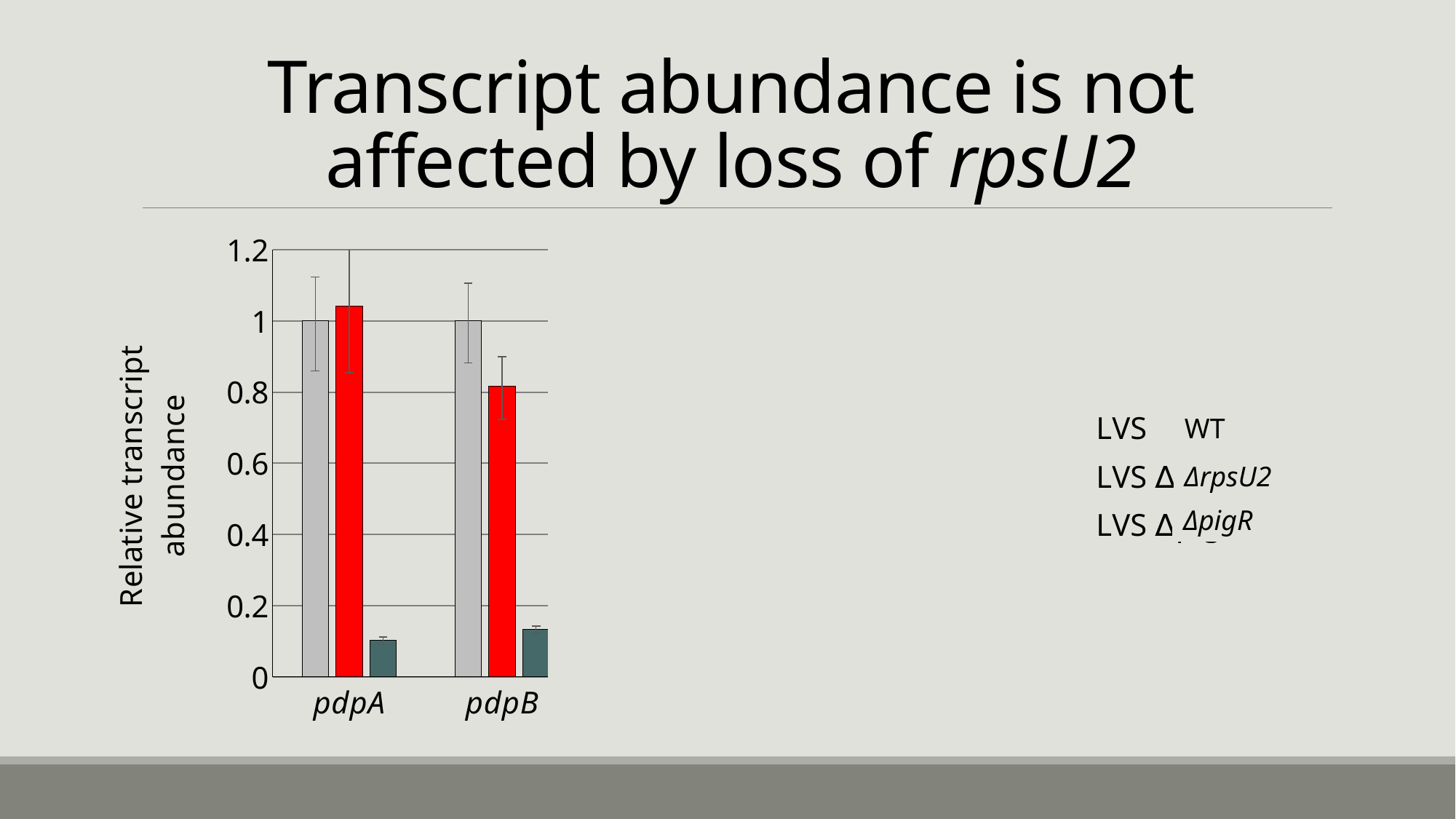
How many categories are shown on the x axis of the chart? 2 Is the value for the ΔpigR series at pdpA greater or less than 0.2? less What is the title of the chart's y axis? Relative transcript abundance Which series has the lowest value for pdpA? ΔpigR Which series has the highest value for pdpB? WT Is the value for the ΔpigR series at pdpB greater or less than 0.2? less How many series does the chart's legend list? 3 What is the relative transcript abundance of the WT series for pdpB? 1 Is the value for the ΔrpsU2 series at pdpB greater or less than 1? less For the ΔrpsU2 series, which category has the larger value, pdpA or pdpB? pdpA What is the relative transcript abundance of the WT series for pdpA? 1 What kind of chart is shown on the slide? bar chart